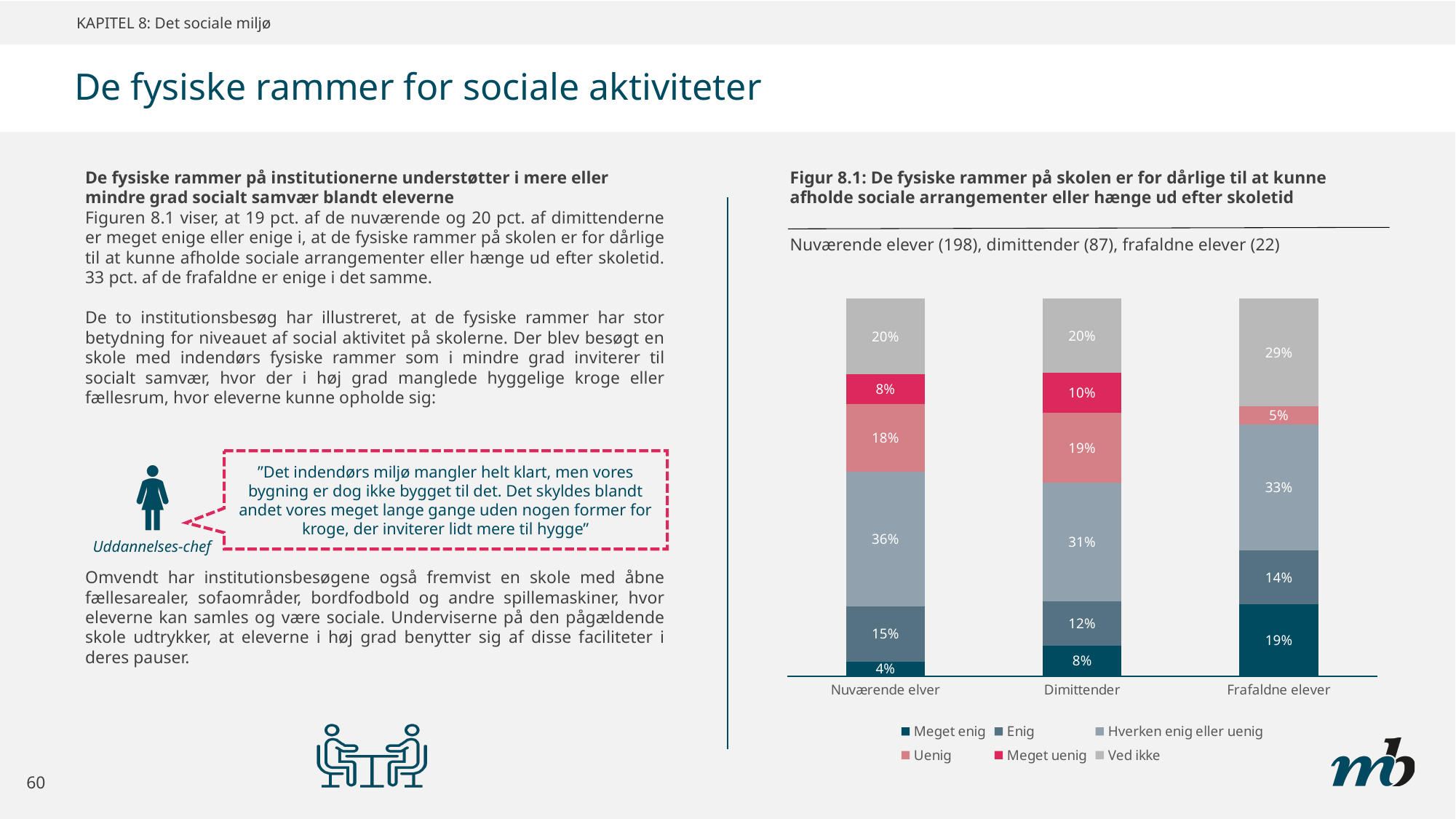
What is the value for 'Meget enig' among Frafaldne elever? 19% How many categories (groups of respondents) are shown on the x axis of the chart? 3 What is the value for 'Uenig' among Dimittender? 19% What kind of chart is shown in Figur 8.1? Stacked bar chart What is the value for 'Hverken enig eller uenig' among Nuværende elever? 36% What is the value for 'Ved ikke' among Frafaldne elever? 29% What is the title of the figure on the slide? Figur 8.1: De fysiske rammer på skolen er for dårlige til at kunne afholde sociale arrangementer eller hænge ud efter skoletid Which group has the lowest share of 'Meget enig'? Nuværende elever What is the difference in 'Meget uenig' between Dimittender and Nuværende elever? 2 percentage points Which group has the larger share of 'Hverken enig eller uenig', Nuværende elever or Dimittender? Nuværende elever How many series does the chart's legend list? 6 Which group has the highest share of 'Meget enig'? Frafaldne elever